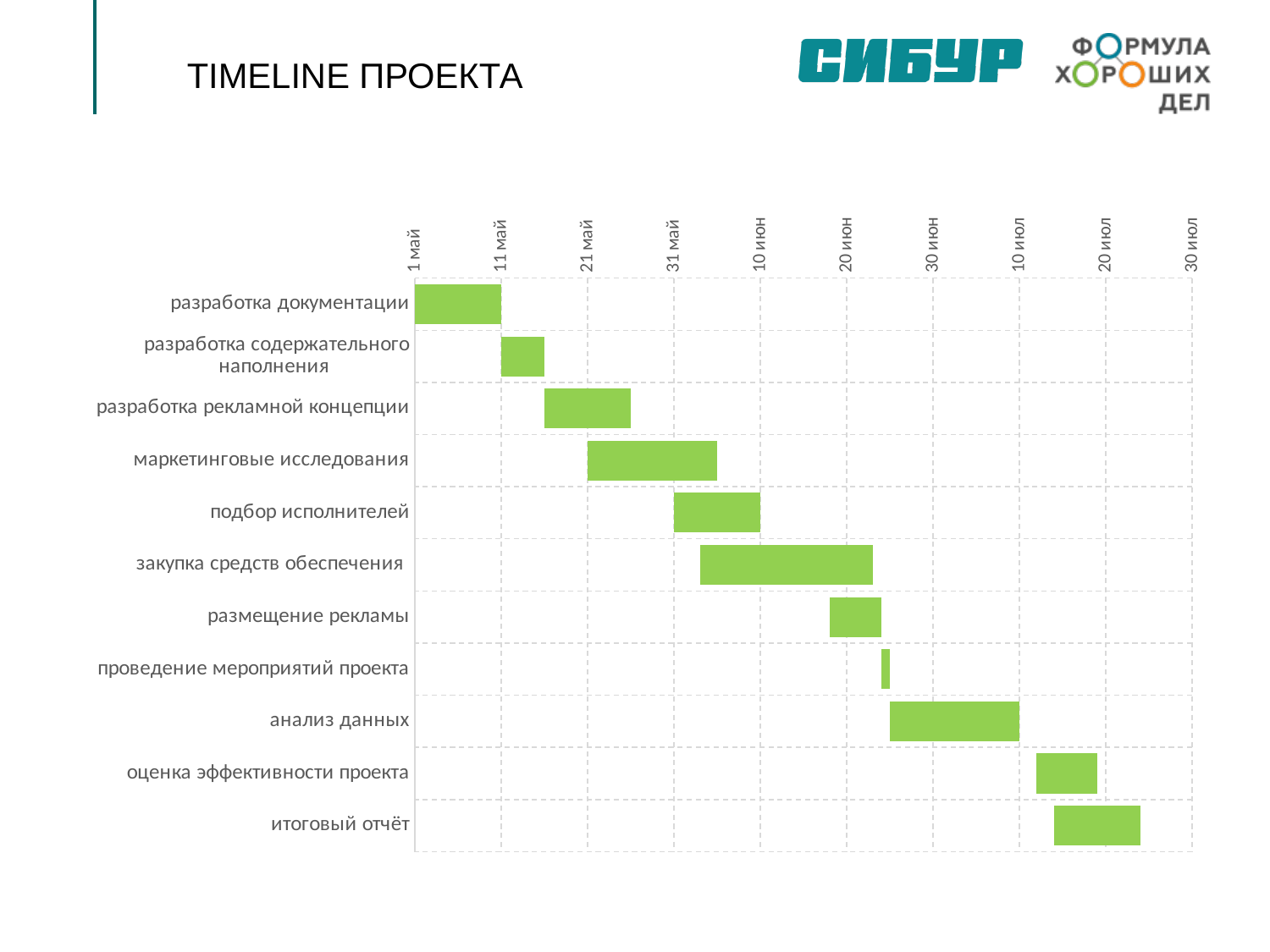
On which date tick does the bar for 'разработка документации' start? 1 май What is the title of the slide with the chart? TIMELINE ПРОЕКТА What colour are the bars in the chart? green Which task has the longest bar in the chart? закупка средств обеспечения How many tasks (categories) are listed on the vertical axis of the chart? 11 What kind of chart is shown on the slide? bar chart On which date tick does the bar for 'разработка документации' end? 11 май On which date tick does the bar for 'анализ данных' end? 10 июл On which date tick does the bar for 'подбор исполнителей' end? 10 июн Which task has the shortest bar in the chart? проведение мероприятий проекта Do the bars start later or earlier as you move down the list of tasks? later Which task starts earlier, 'размещение рекламы' or 'анализ данных'? размещение рекламы